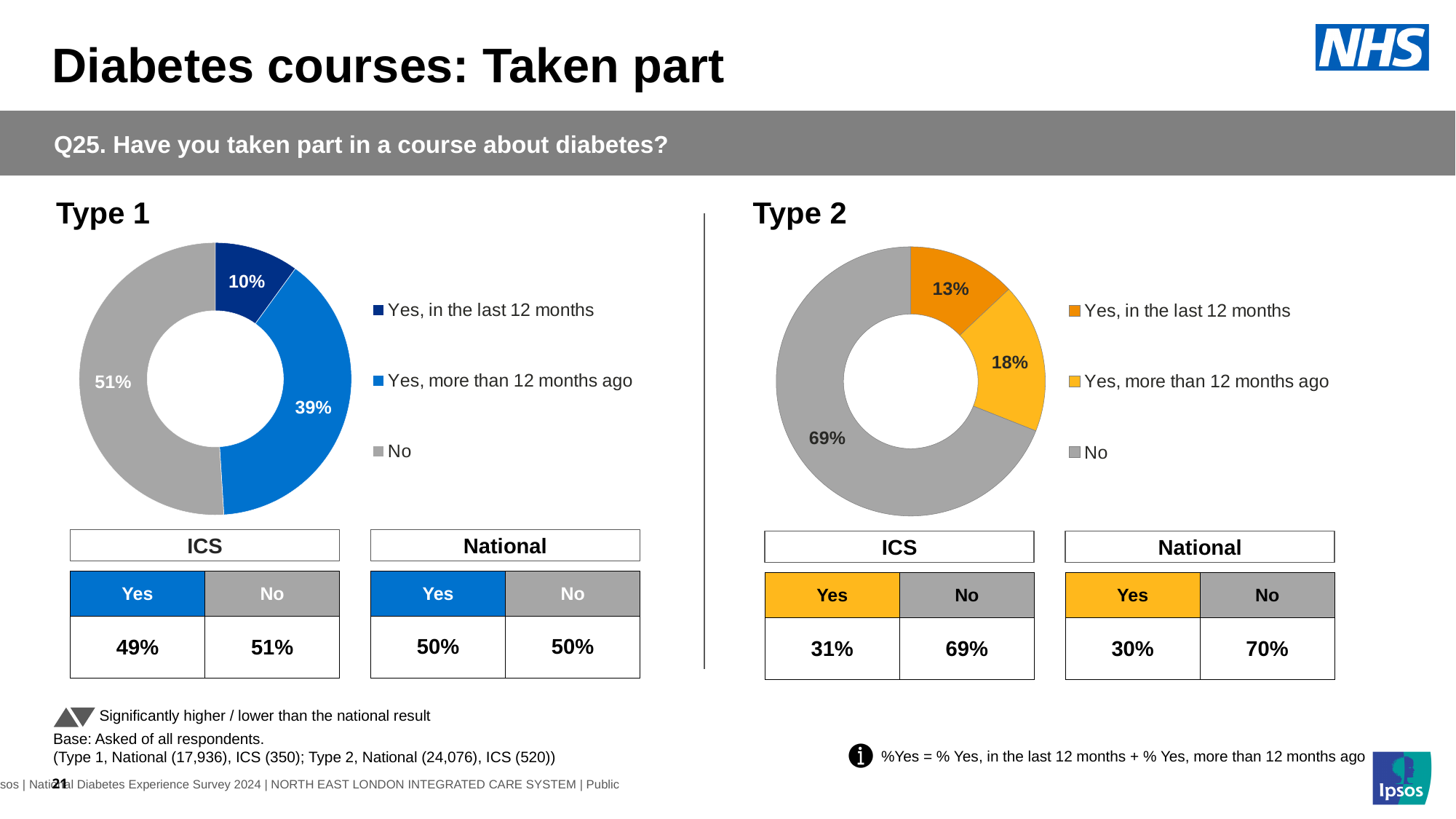
In the Type 1 chart, what is the difference between the 'Yes, more than 12 months ago' share and the 'Yes, in the last 12 months' share? 29% In the Type 2 chart, what is the difference between the 'No' share and the 'Yes, more than 12 months ago' share? 51% How many categories does the Type 2 chart show? 3 In the Type 2 chart, which category has the smallest share? Yes, in the last 12 months In the Type 2 chart, what percentage of respondents said 'Yes, more than 12 months ago'? 18% In the Type 1 chart, which category has the largest share? No Is the 'Yes, in the last 12 months' share larger in the Type 1 chart or the Type 2 chart? Type 2 What colour represents 'No' in the Type 2 chart? Grey What kind of chart is used for Type 1? Doughnut chart In the Type 1 chart, what percentage of respondents said 'Yes, in the last 12 months'? 10% In the Type 2 chart, what percentage of respondents said 'No'? 69% In the Type 1 chart, what percentage of respondents said 'Yes, more than 12 months ago'? 39%